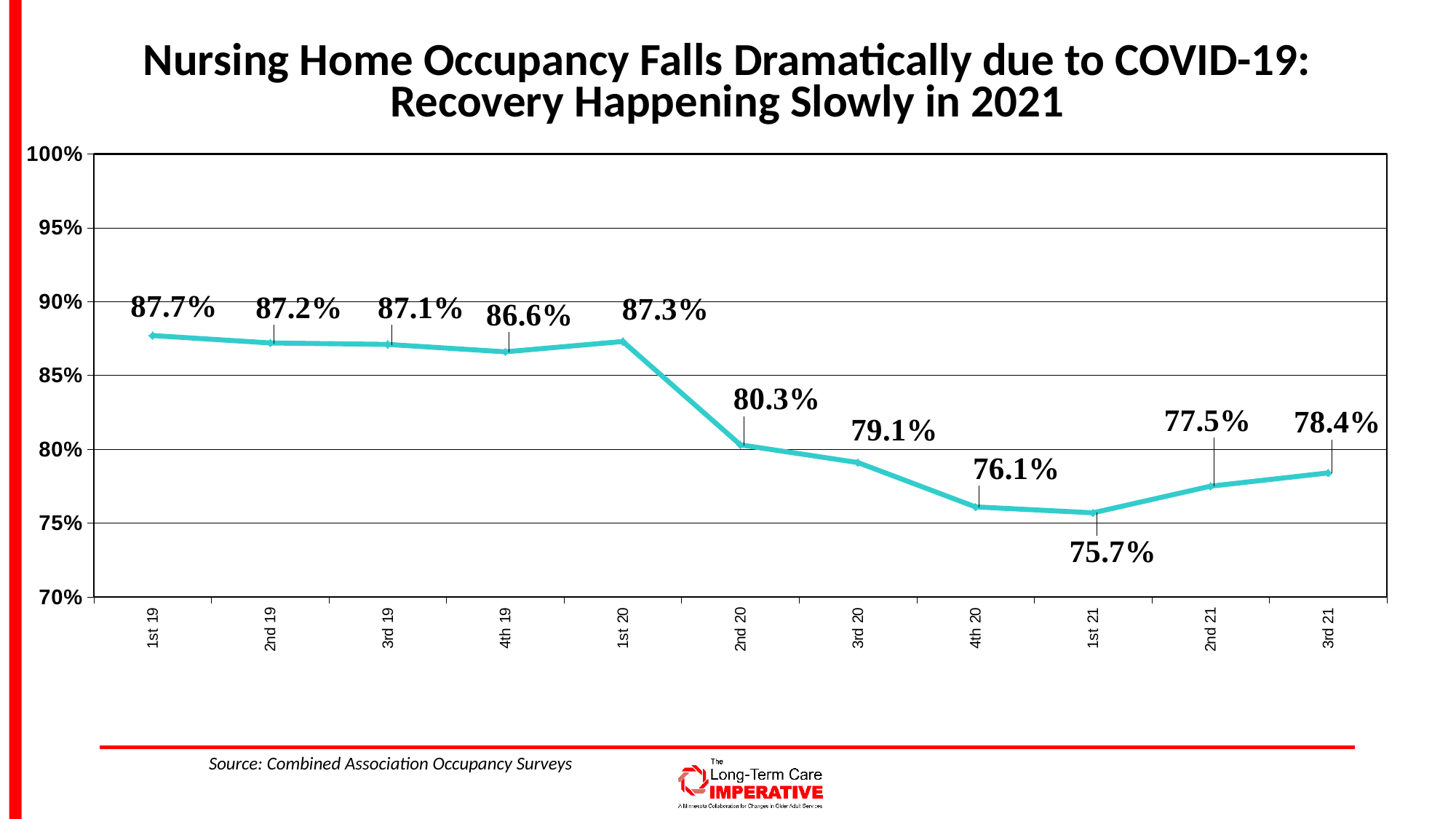
What is the nursing home occupancy rate for 1st 19? 87.7% What is the occupancy rate shown for 2nd 20? 80.3% Which is larger, the occupancy rate for 4th 20 or for 2nd 21? 2nd 21 Which quarter has the highest occupancy rate? 1st 19 What is the difference in occupancy between 1st 20 and 2nd 20? 7.0% Does the occupancy rate rise or fall from 1st 21 to 3rd 21? rise What source is cited for the chart data? Combined Association Occupancy Surveys How many quarters are plotted on the chart? 11 What kind of chart is shown on the slide? line chart What is the occupancy rate shown for 3rd 21? 78.4% Is the occupancy rate for 3rd 20 greater or less than 80%? less Which quarter has the lowest occupancy rate? 1st 21